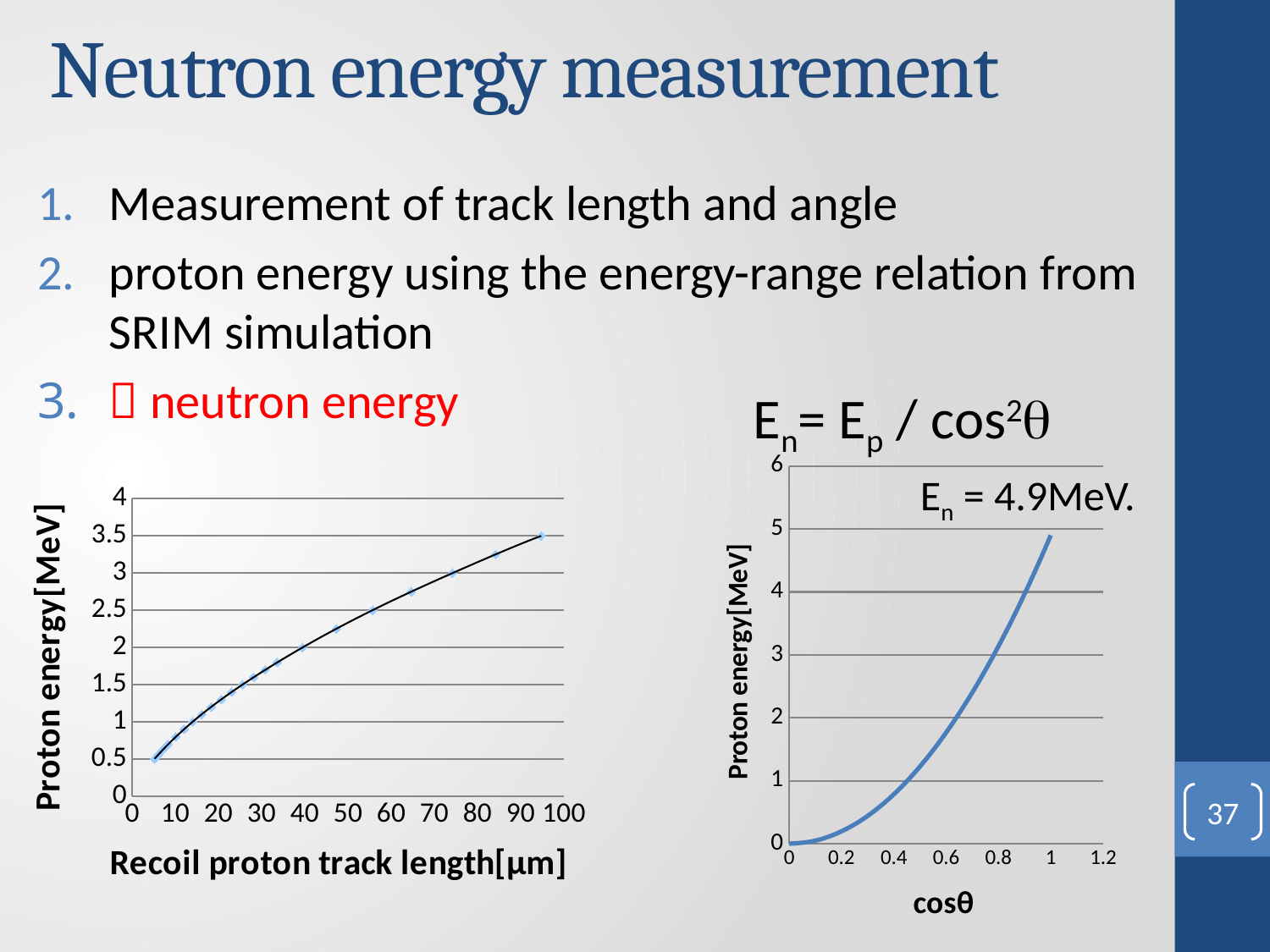
What neutron energy value is annotated on the right chart? En = 4.9MeV In the left chart, is the proton energy at a track length of 50 µm greater or less than 2 MeV? greater What kind of chart is the right chart, with cosθ on the x axis? line chart What is the x-axis label of the left chart? Recoil proton track length[μm] In the right chart, is the proton energy at cosθ = 0.4 greater or less than 1 MeV? less In the left chart, is the proton energy at a track length of 80 µm greater or less than 3.5 MeV? less In the left chart, does proton energy rise or fall as recoil proton track length increases? rise In the right chart, does proton energy rise or fall as cosθ increases? rise What kind of chart is the left chart, with recoil proton track length on the x axis? line chart